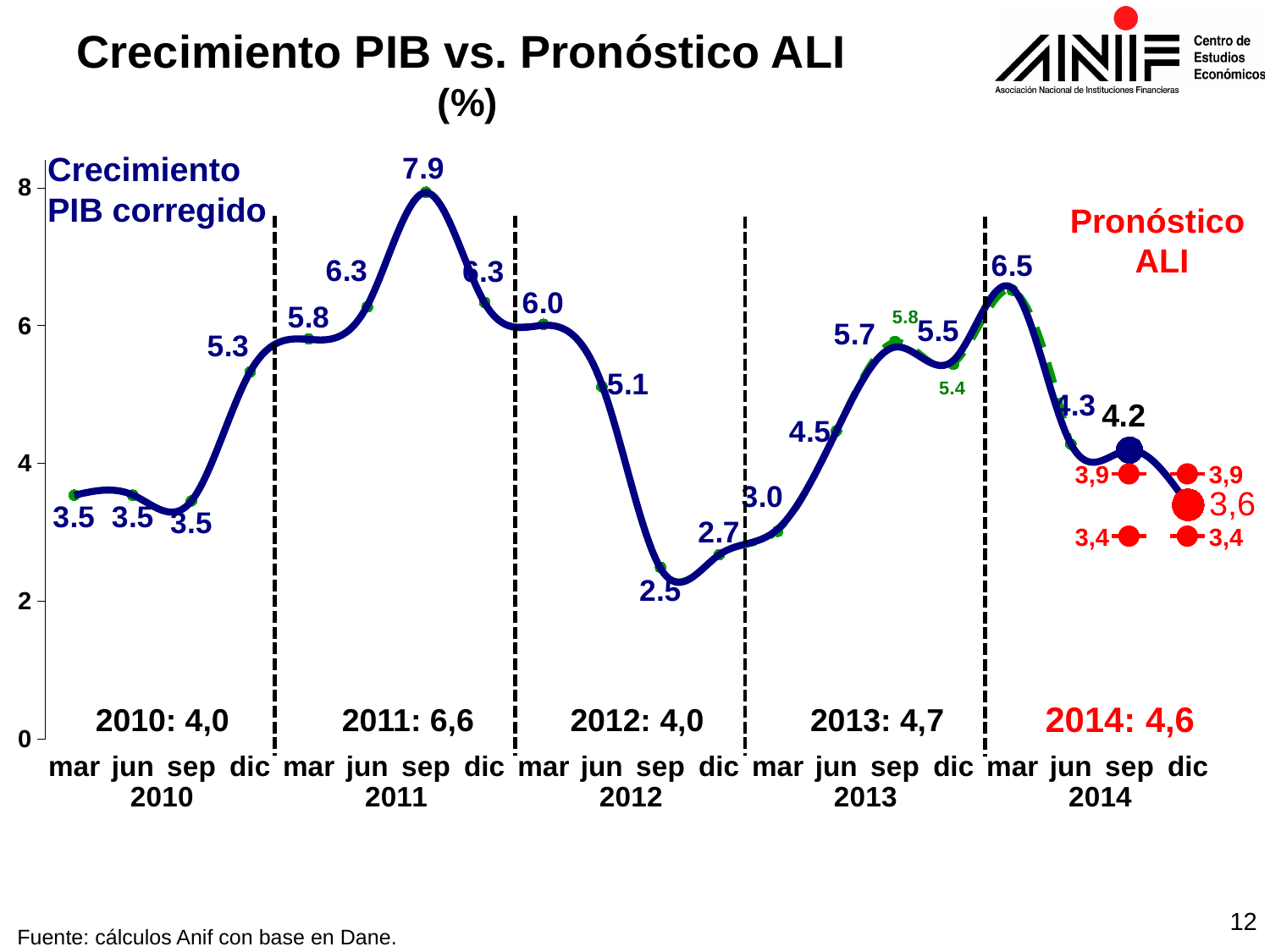
What is the ALI forecast value shown for dic 2014? 3,6 In which quarter does the GDP growth line reach its highest value? sep 2011 Which is larger, the value for jun 2012 or the value for jun 2013? jun 2012 Do the values rise or fall from mar 2014 to dic 2014? fall What is the difference between the highest value (sep 2011) and the lowest value (sep 2012)? 5.4 What is the GDP growth value for sep 2011? 7.9 In which quarter does the GDP growth line reach its lowest value? sep 2012 What is the GDP growth value for mar 2012? 6.0 What is the annual growth figure shown for 2011? 6,6 What is the annual growth figure shown for 2014? 4,6 What kind of chart is shown on the slide? line chart What is the title of the chart? Crecimiento PIB vs. Pronóstico ALI (%)